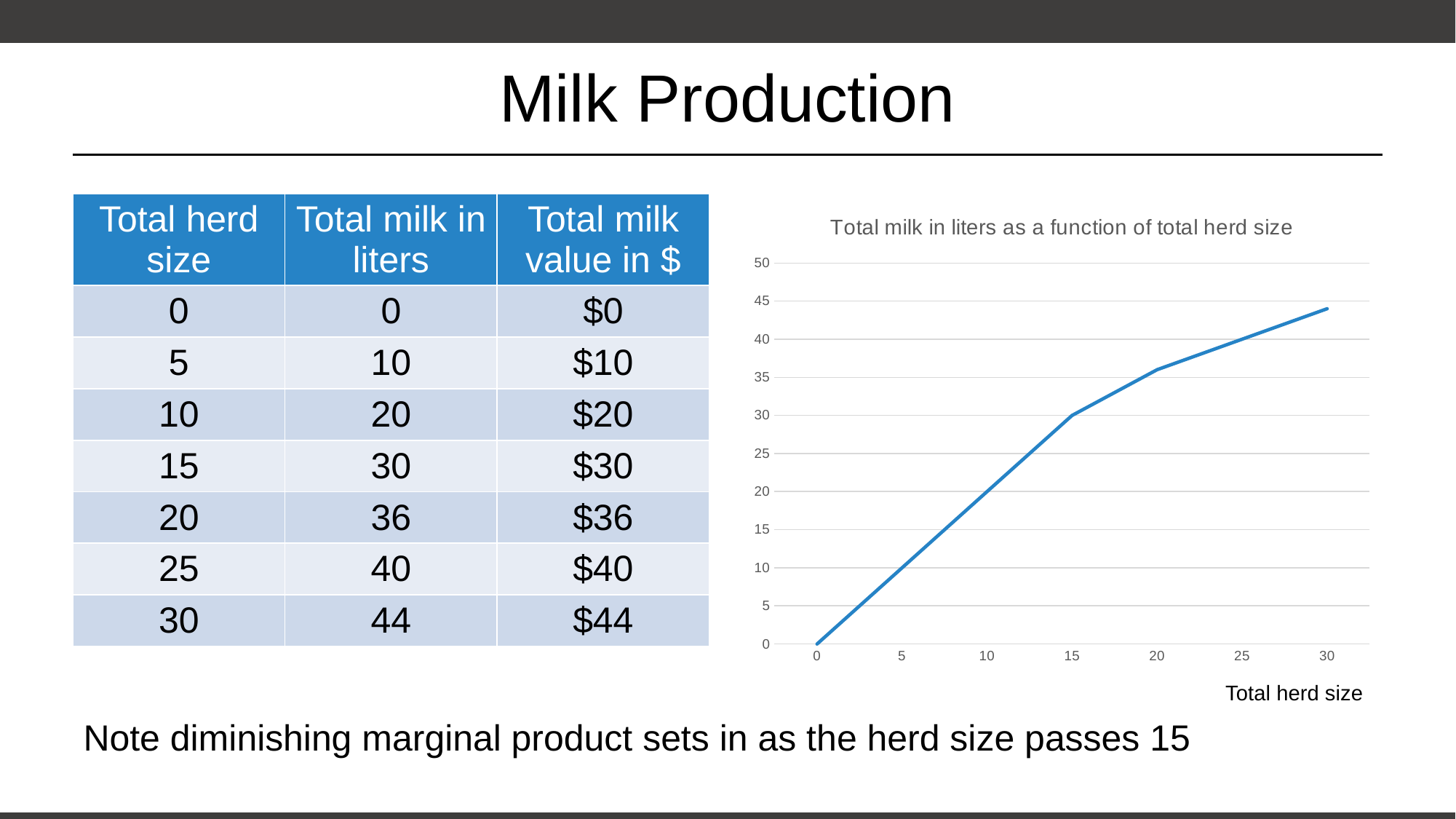
Is the total milk in liters at a herd size of 25 greater or less than 45? less At which total herd size is the total milk in liters highest on the chart? 30 According to the chart, what is the total milk in liters when the total herd size is 15? 30 What is the difference in total milk in liters between a herd size of 30 and a herd size of 20? 8 At which total herd size is the total milk in liters lowest on the chart? 0 According to the chart, what is the total milk in liters when the total herd size is 30? 44 Does the total milk in liters rise or fall as the total herd size increases along the x axis? rise Is the total milk in liters at a herd size of 20 greater or less than 35? greater What is the title of the chart? Total milk in liters as a function of total herd size What is the label of the x axis of the chart? Total herd size What kind of chart is shown on the slide? line chart According to the chart, what is the total milk in liters when the total herd size is 5? 10